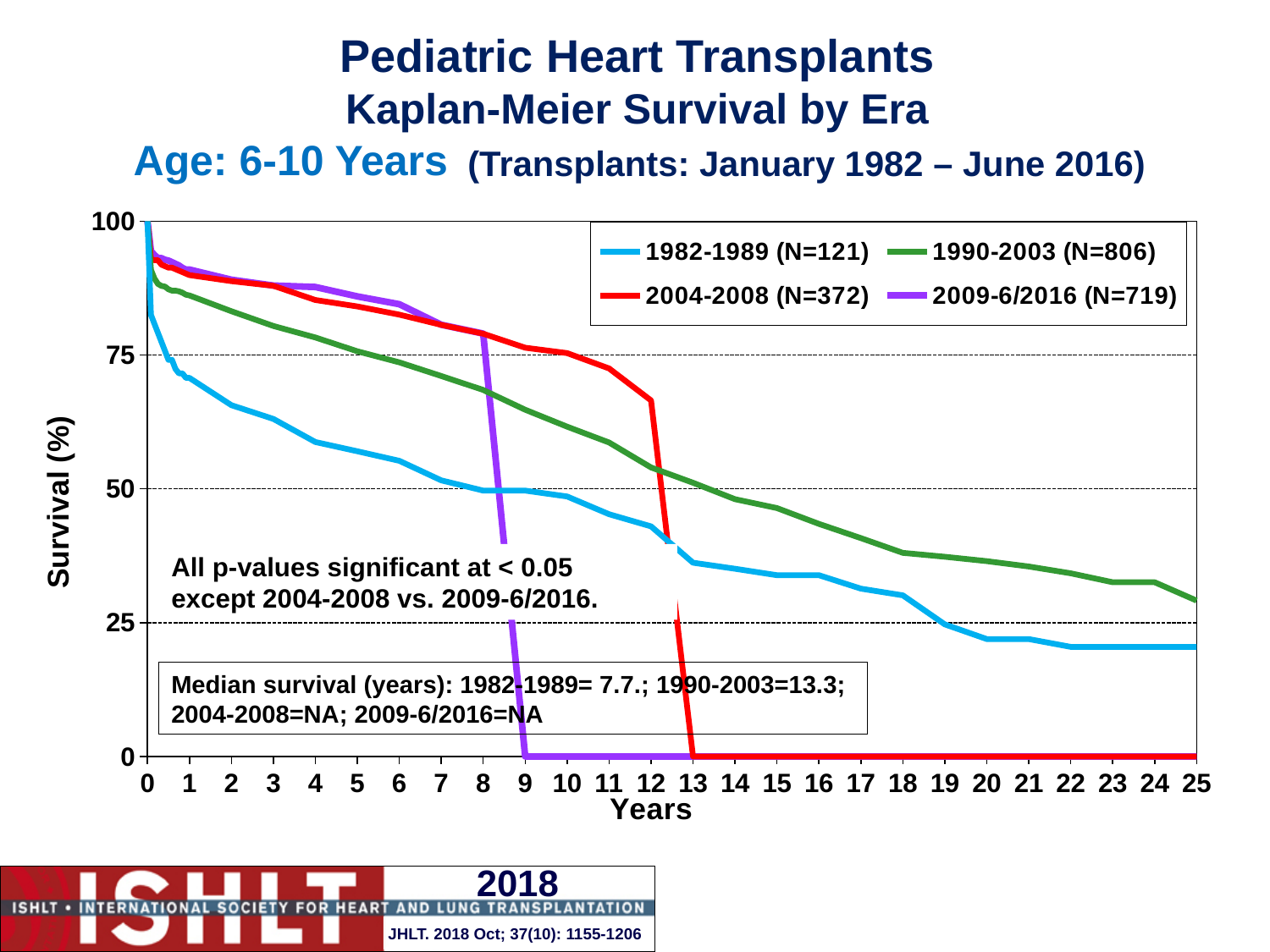
Is the survival value for the 1982-1989 era at year 5 greater or less than 50? greater Do the survival curves rise or fall as years increase along the x axis? fall How many series does the legend list? 4 What is the label of the y axis? Survival (%) Is the survival value for the 1990-2003 era at year 10 greater or less than 50? greater What is the median survival in years for the 1982-1989 era, as stated on the slide? 7.7 Is the survival value for the 2004-2008 era at year 5 greater or less than 75? greater What is the median survival in years for the 1990-2003 era, as stated on the slide? 13.3 What kind of chart is shown on the slide? line chart Which era has the largest number of transplants (N) according to the legend? 1990-2003 (N=806) At year 10, which era has higher survival: 1990-2003 or 1982-1989? 1990-2003